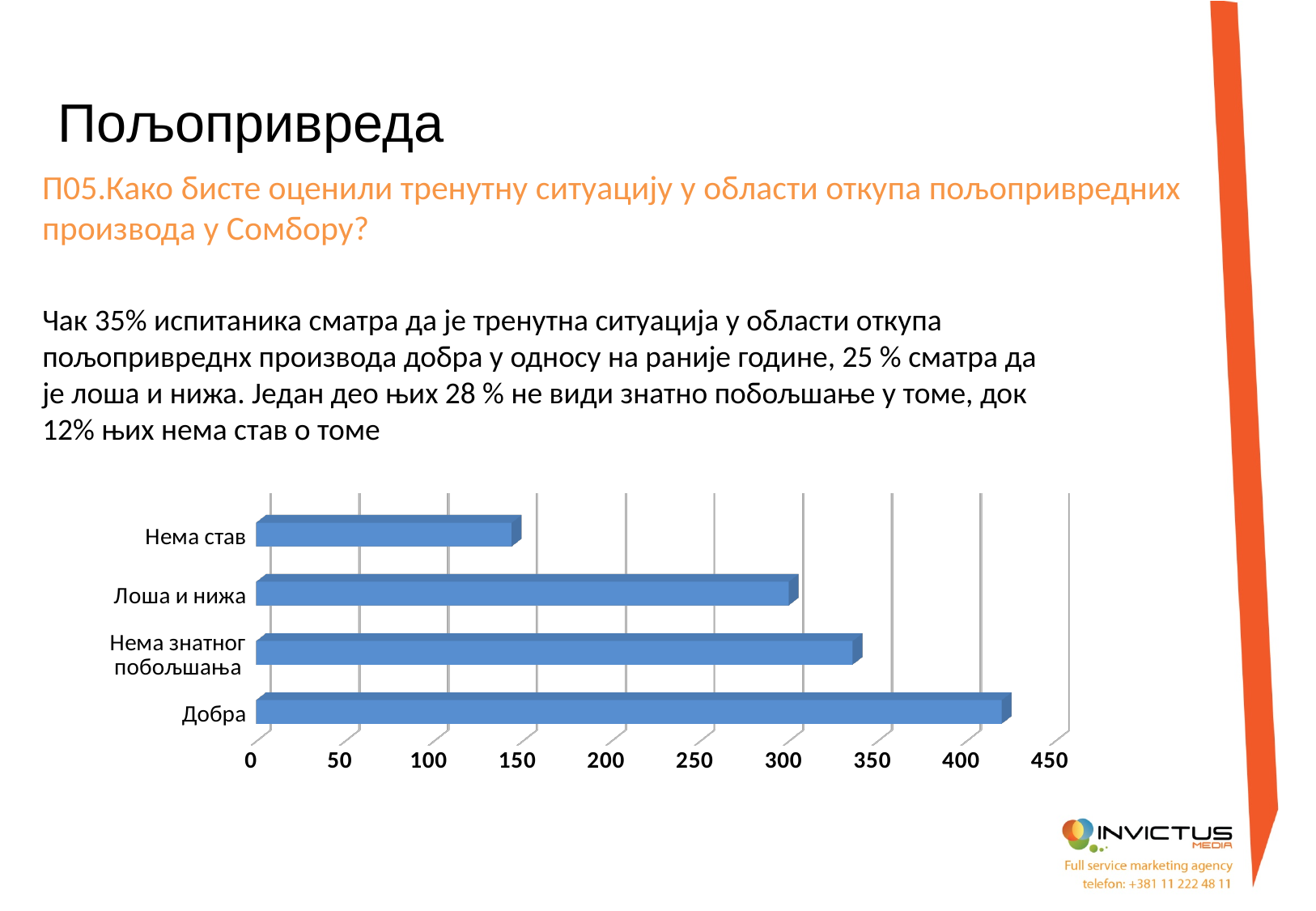
Which category has the lowest value in the chart? Нема став Is the value for Нема став greater or less than 100? greater Which is larger, the value for Нема став or the value for Лоша и нижа? Лоша и нижа What is the maximum value shown on the horizontal axis of the chart? 450 Which category has the highest value in the chart? Добра How many categories are shown in the chart? 4 Which is larger, the value for Лоша и нижа or the value for Нема знатног побољшања? Нема знатног побољшања Is the value for Добра greater or less than 400? greater Is the value for Лоша и нижа greater or less than 250? greater What colour are the bars in the chart? blue What kind of chart is shown on the slide? bar chart